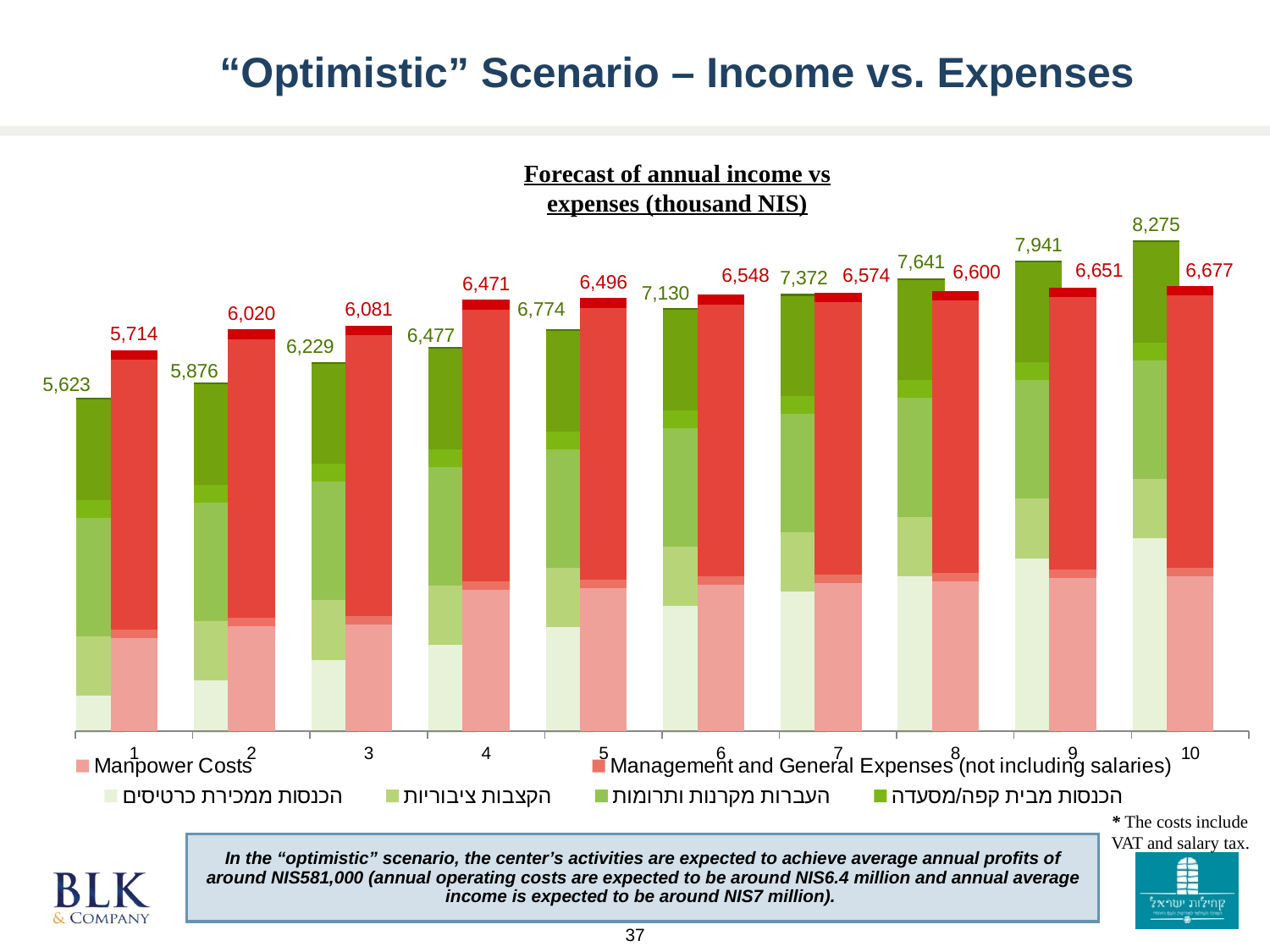
What is the total income (green stacked bar) shown for year 10? 8,275 How many years are shown on the x axis? 10 What is the total expenses (red stacked bar) shown for year 1? 5,714 In year 2, which is larger: total income or total expenses? Total expenses What is the difference between total income and total expenses in year 10? 1,598 What is the total expenses shown for year 8? 6,600 How many series does the legend list? 6 Does total income rise or fall from year 1 to year 10? Rise What is the total income shown for year 6? 7,130 In which year is the total income bar highest? 10 What kind of chart is shown on the slide? Stacked bar chart In which year is the total expenses bar lowest? 1